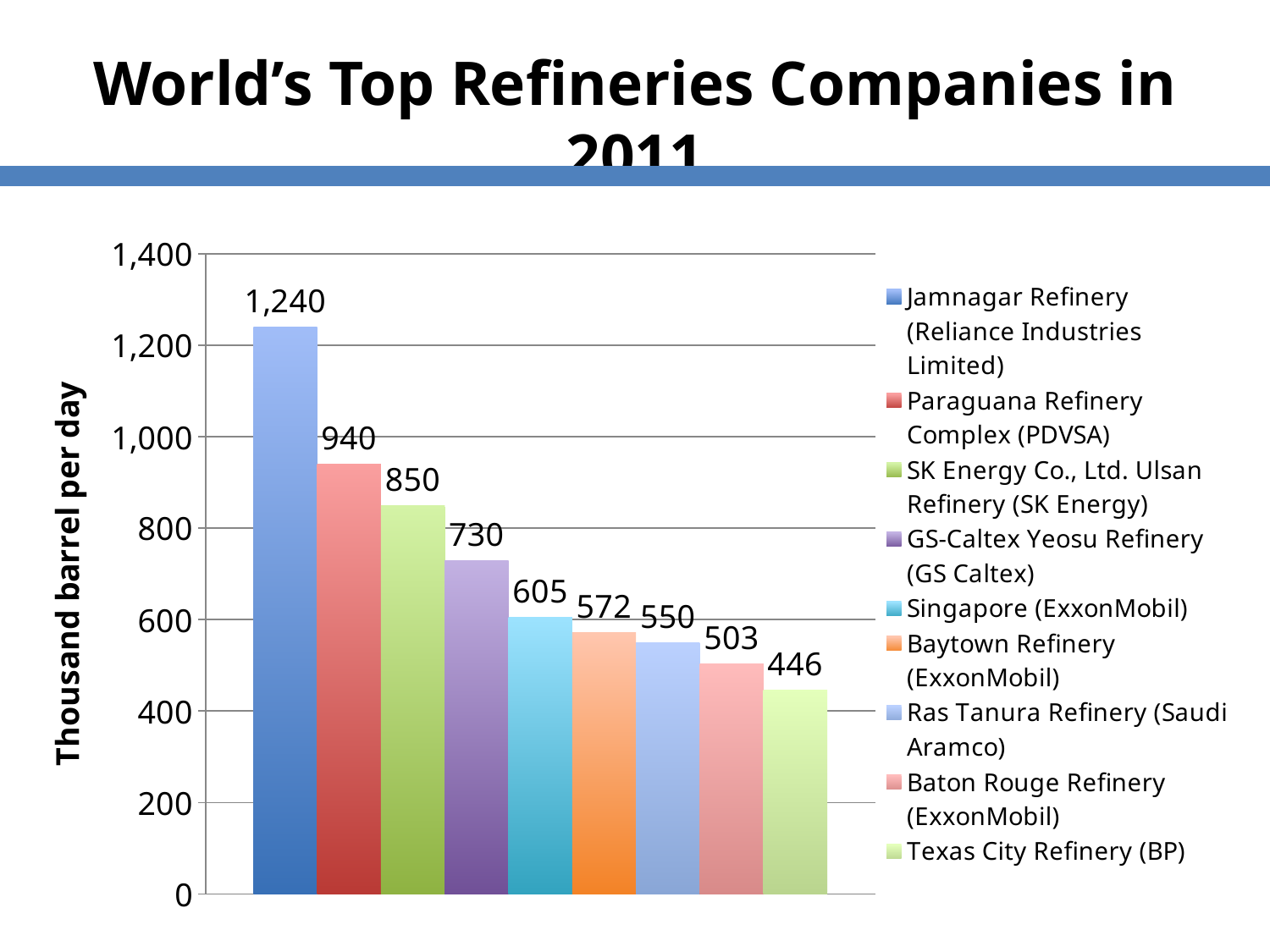
How many refineries are plotted in the chart? 9 Which refinery has the lowest value? Texas City Refinery (BP) Which is larger, the value for GS-Caltex Yeosu Refinery (GS Caltex) or the value for Baytown Refinery (ExxonMobil)? GS-Caltex Yeosu Refinery (GS Caltex) What is the value for Singapore (ExxonMobil)? 605 What is the label of the vertical axis? Thousand barrel per day How many entries does the legend list? 9 What is the value for Texas City Refinery (BP)? 446 What is the value for Jamnagar Refinery (Reliance Industries Limited)? 1,240 Is the value for Ras Tanura Refinery (Saudi Aramco) greater or less than 600? less What kind of chart is shown on the slide? bar chart What is the difference between the values for Paraguana Refinery Complex (PDVSA) and SK Energy Co., Ltd. Ulsan Refinery (SK Energy)? 90 Which refinery has the highest value? Jamnagar Refinery (Reliance Industries Limited)